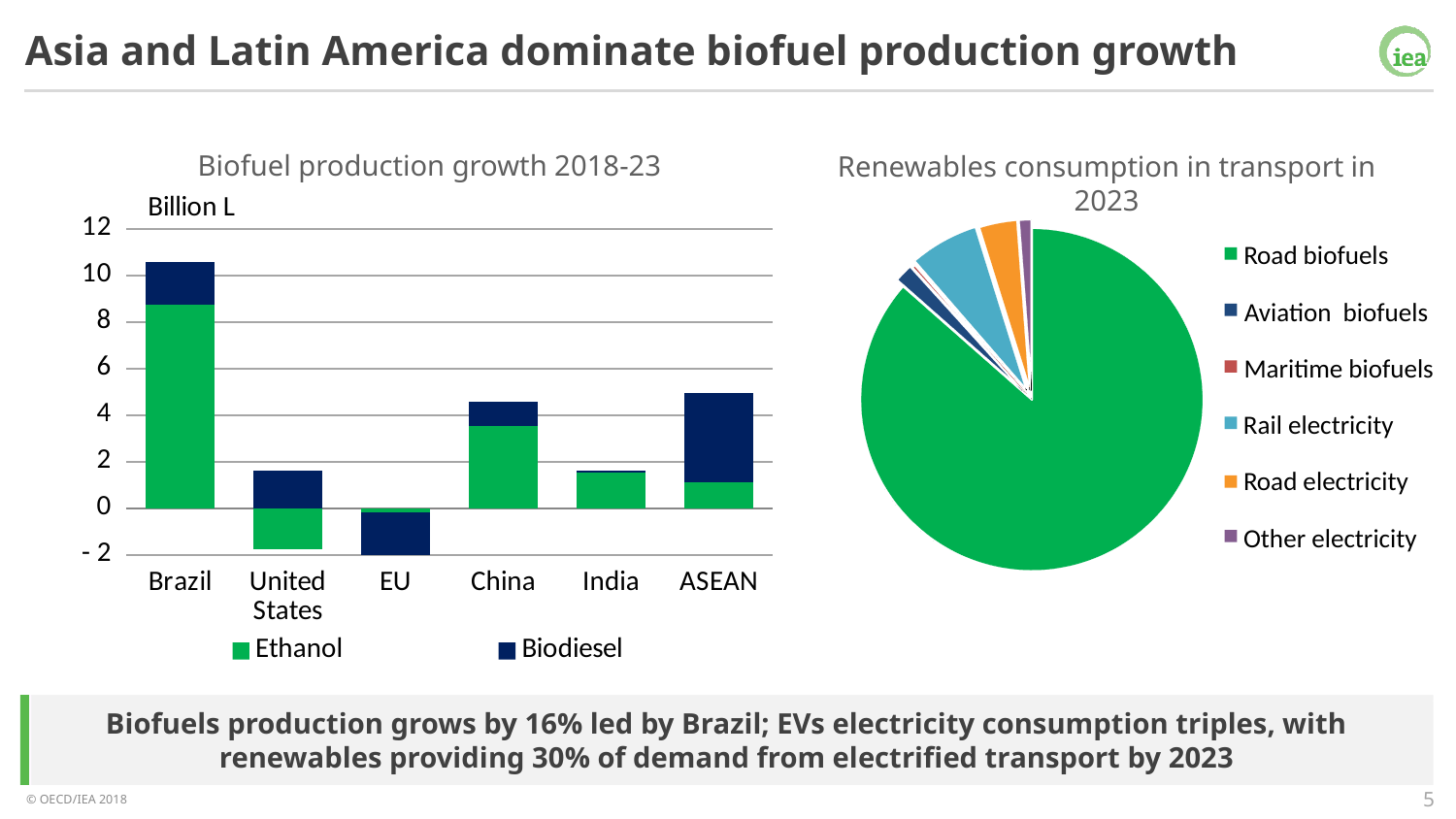
In the 'Biofuel production growth 2018-23' chart, is the total bar for China greater or less than 4? greater What unit is shown on the y axis of the 'Biofuel production growth 2018-23' chart? Billion L In the 'Biofuel production growth 2018-23' chart, which region has the highest total biofuel production growth? Brazil In the 'Renewables consumption in transport in 2023' chart, how many categories does the legend list? 6 What kind of chart is the 'Biofuel production growth 2018-23' chart? bar chart What kind of chart is the 'Renewables consumption in transport in 2023' chart? pie chart In the 'Biofuel production growth 2018-23' chart, is the Biodiesel value for the EU greater or less than 0? less In the 'Biofuel production growth 2018-23' chart, how many series does the legend list? 2 In the 'Biofuel production growth 2018-23' chart, is the Ethanol value for Brazil greater or less than 8? greater In the 'Renewables consumption in transport in 2023' chart, which category has the largest slice? Road biofuels In the 'Biofuel production growth 2018-23' chart, how many regions are shown on the x axis? 6